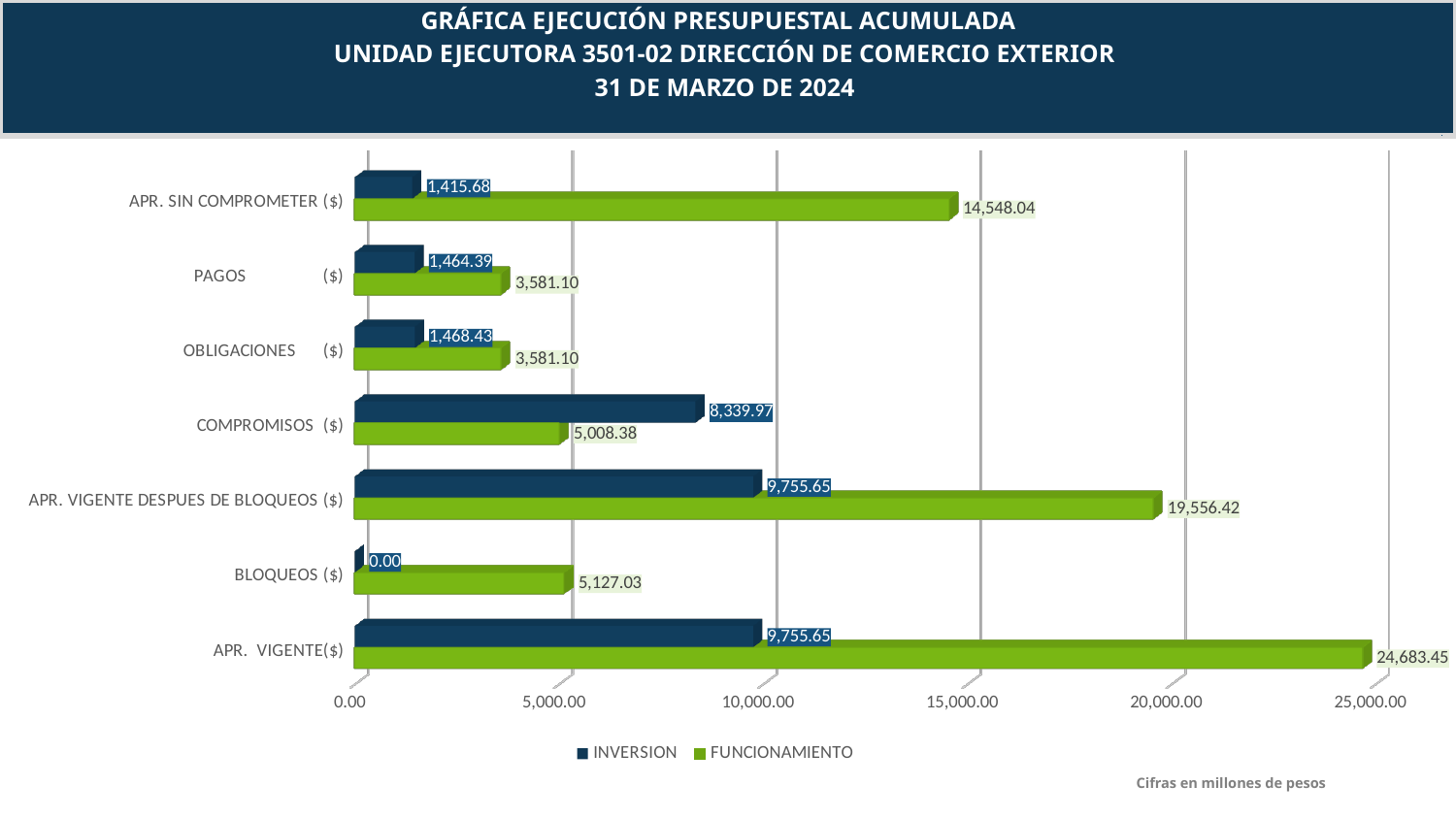
Which category has the lowest INVERSION value? BLOQUEOS ($) Is the FUNCIONAMIENTO value for APR. SIN COMPROMETER ($) greater or less than 10,000.00? greater What kind of chart is shown on the slide? Bar chart What is the FUNCIONAMIENTO value for BLOQUEOS ($)? 5,127.03 How many series does the legend list? 2 What is the INVERSION value for COMPROMISOS ($)? 8,339.97 What is the difference between the FUNCIONAMIENTO values for APR. VIGENTE($) and APR. VIGENTE DESPUES DE BLOQUEOS ($)? 5,127.03 What is the FUNCIONAMIENTO value for APR. VIGENTE($)? 24,683.45 What is the INVERSION value for BLOQUEOS ($)? 0.00 How many categories are shown on the chart? 7 Which category has the highest FUNCIONAMIENTO value? APR. VIGENTE($) For COMPROMISOS ($), which series has the larger value, INVERSION or FUNCIONAMIENTO? INVERSION